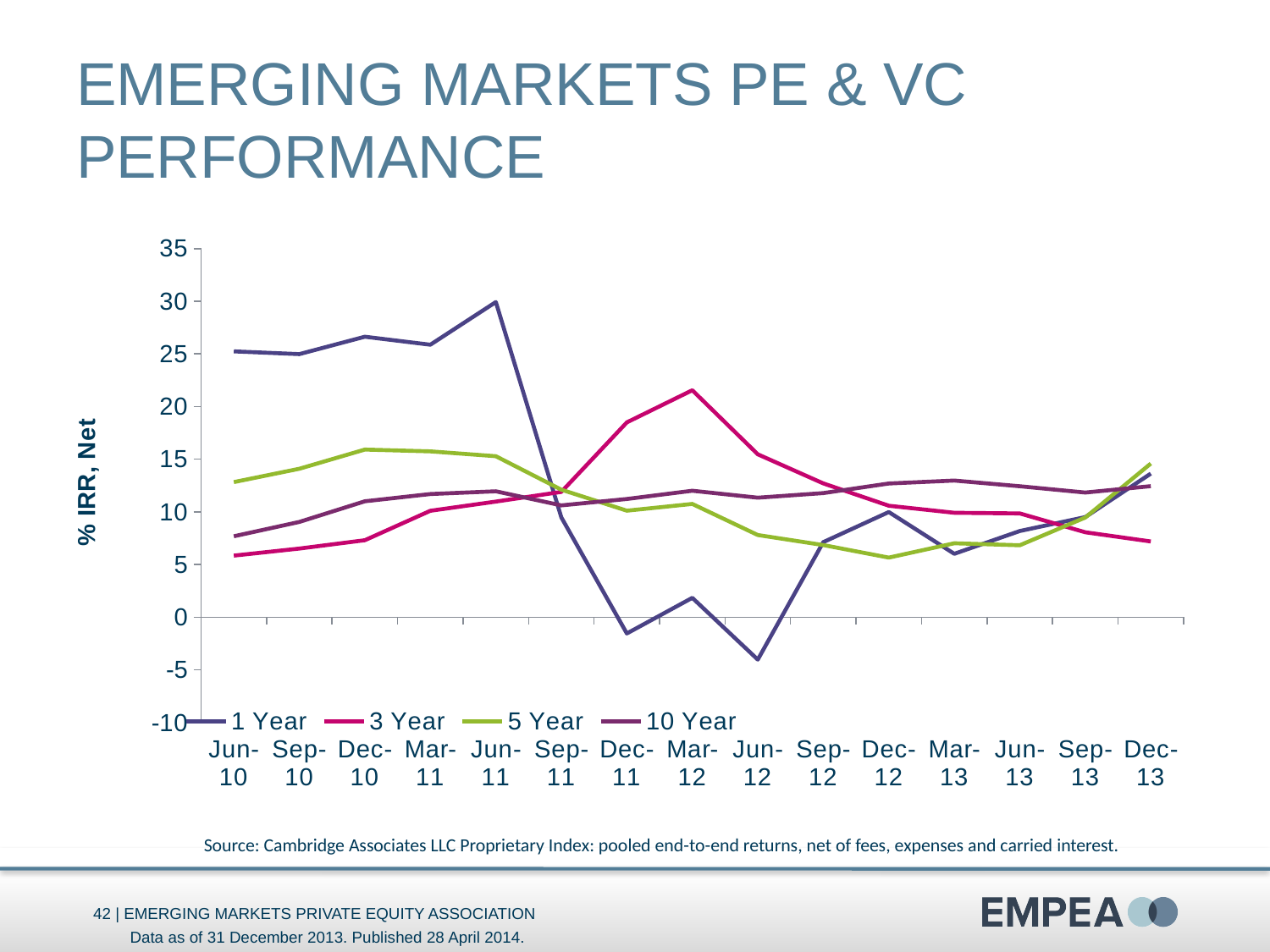
Which series has the lowest value at Jun-12? 1 Year What kind of chart is shown on the slide? line chart At Dec-13, which is larger: the 5 Year value or the 3 Year value? 5 Year Is the 1 Year value at Jun-11 greater or less than 25? greater Which series has the highest value at Jun-11? 1 Year Is the 1 Year value at Jun-12 greater or less than 0? less Is the 3 Year value at Mar-12 greater or less than 20? greater What is the label on the y axis? % IRR, Net Does the 3 Year series rise or fall from Mar-12 to Dec-13? fall How many time points are shown along the x axis? 15 How many series does the legend list? 4